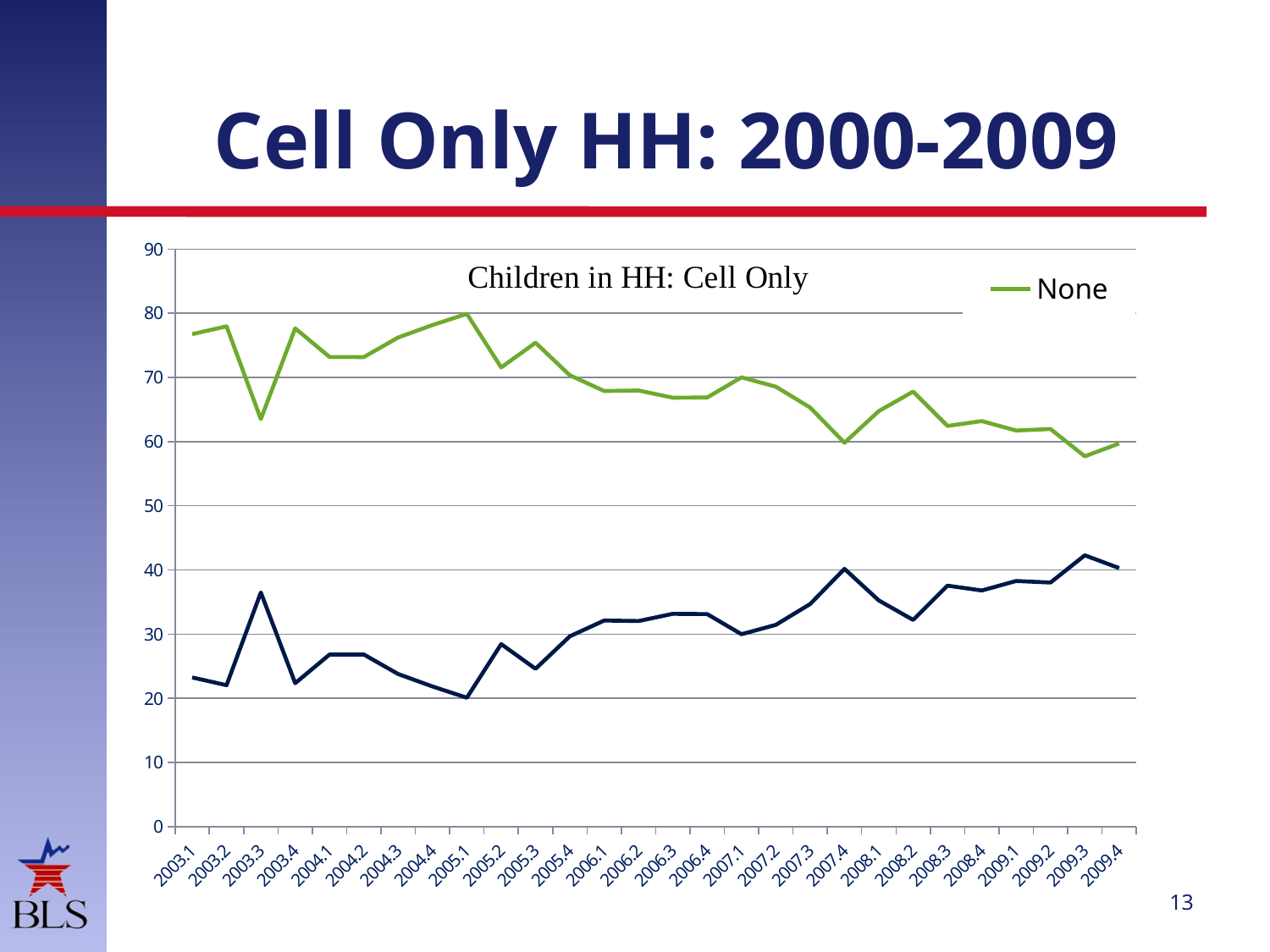
What is the title of the chart? Children in HH: Cell Only At 2003.1, which is larger: the None series or the dark blue line? None Which series name is shown in the chart's legend? None What kind of chart is shown on the slide? line chart Is the value of the None series at 2003.1 greater or less than 70? greater Is the value of the dark blue line at 2005.1 greater or less than 30? less Does the dark blue line generally rise or fall from 2003.1 to 2009.4? rise Is the value of the dark blue line at 2009.3 greater or less than 30? greater How many quarterly points are plotted along the x axis, from 2003.1 to 2009.4? 28 Does the None series generally rise or fall from 2003.1 to 2009.4? fall